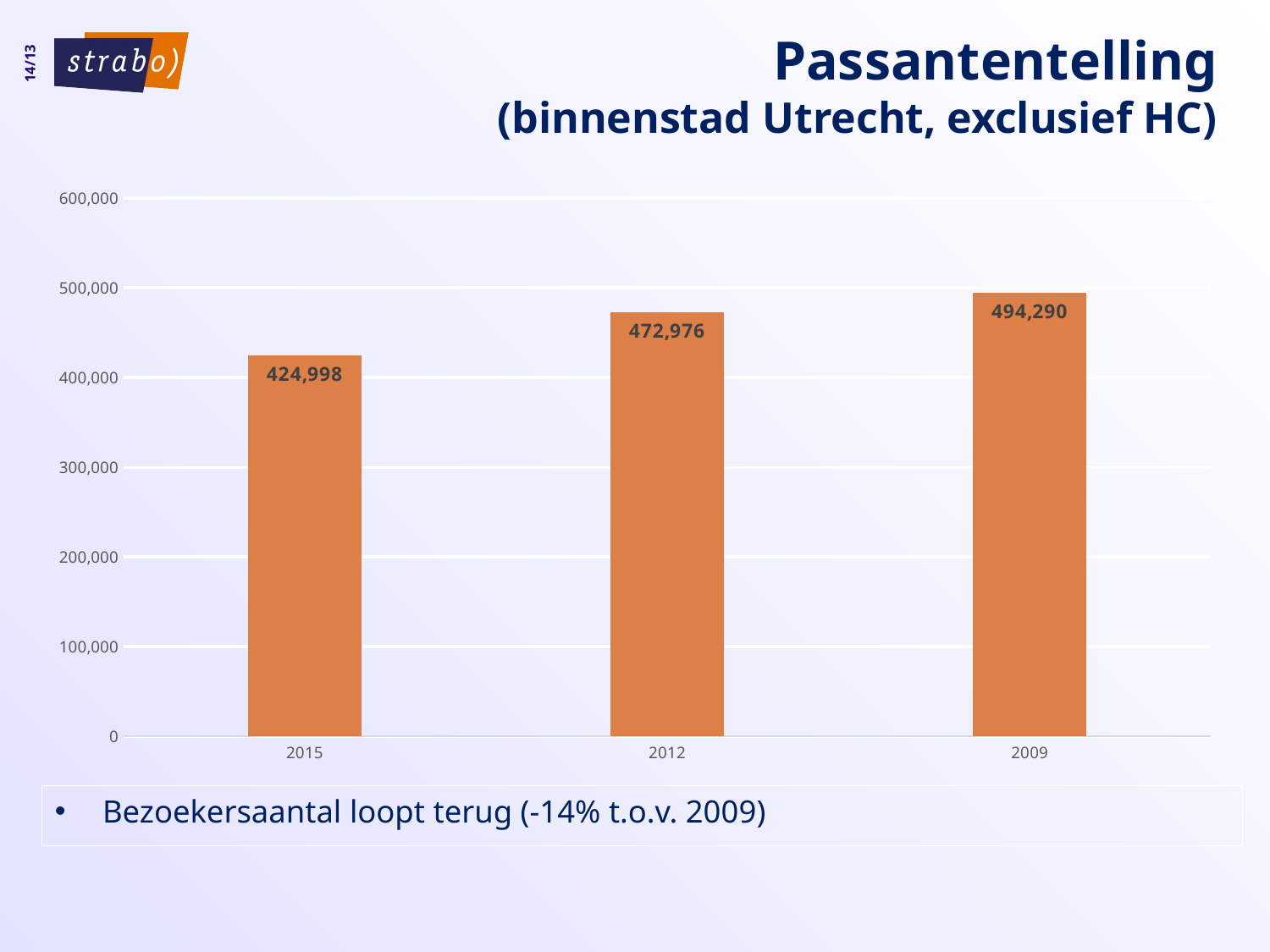
What kind of chart is shown on the slide? bar chart Is the value for 2009 greater or less than 500,000? less What is the value for 2012? 472,976 What is the value for 2015? 424,998 Which year has the highest value? 2009 Do the values rise or fall from left to right along the x axis? rise What is the difference between the values for 2012 and 2015? 47,978 Which is larger, the value for 2012 or the value for 2015? 2012 What is the difference between the values for 2009 and 2015? 69,292 What is the value for 2009? 494,290 Which year has the lowest value? 2015 How many bars are shown in the chart? 3